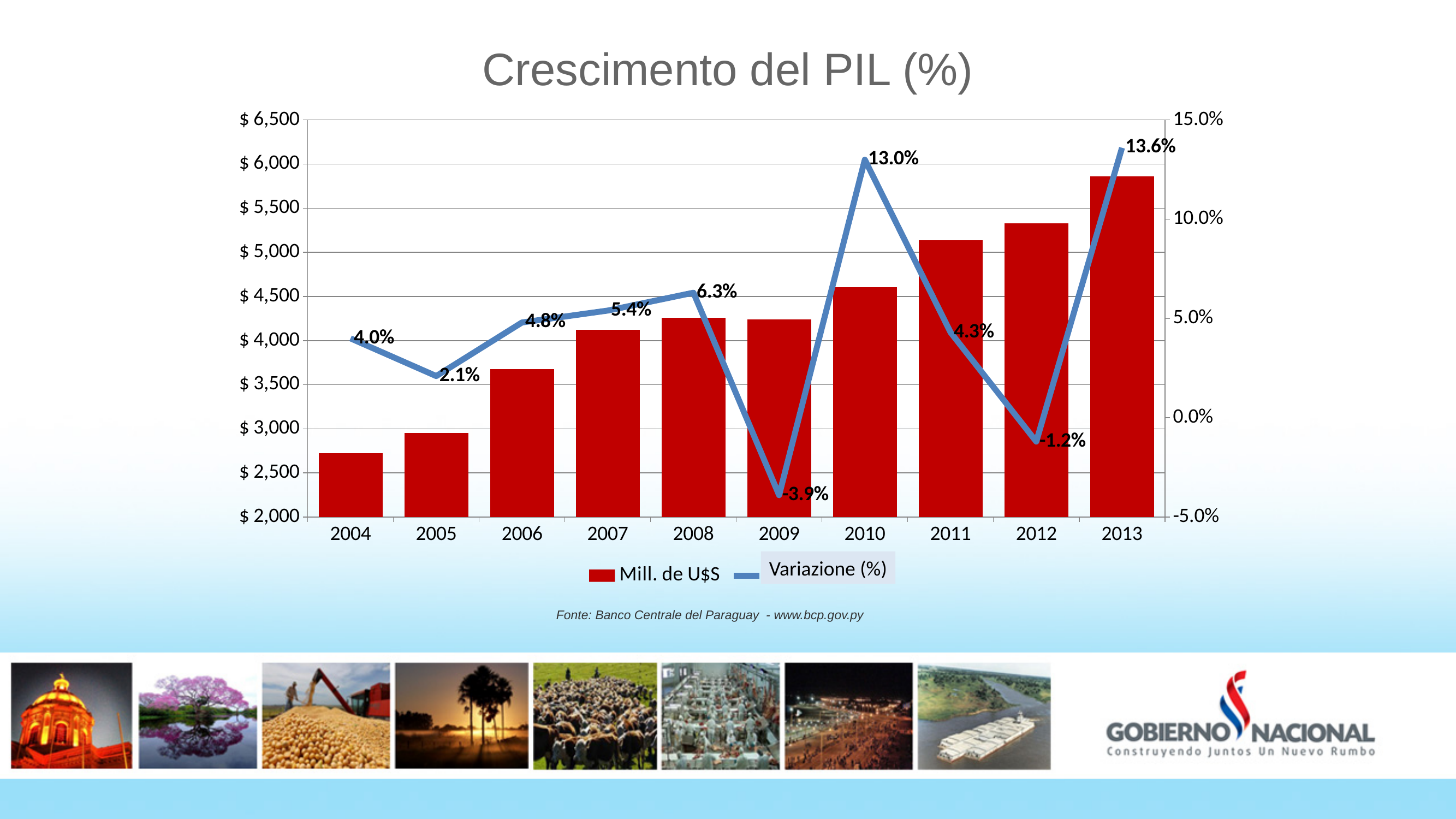
How many series does the legend list? 2 Is the Mill. de U$S bar for 2004 greater or less than $ 3,000? less What is the Variazione (%) value for 2010? 13.0% Is the Mill. de U$S bar for 2013 greater or less than $ 5,500? greater Which year has the lowest Variazione (%) value? 2009 Which year has the larger Variazione (%) value, 2006 or 2011? 2006 How many years are shown on the x axis? 10 What is the difference between the Variazione (%) values for 2010 and 2011? 8.7% What is the Variazione (%) value for 2009? -3.9% Which year has the highest Variazione (%) value? 2013 What is the Variazione (%) value for 2005? 2.1% What kind of chart is shown on the slide? Combination bar and line chart